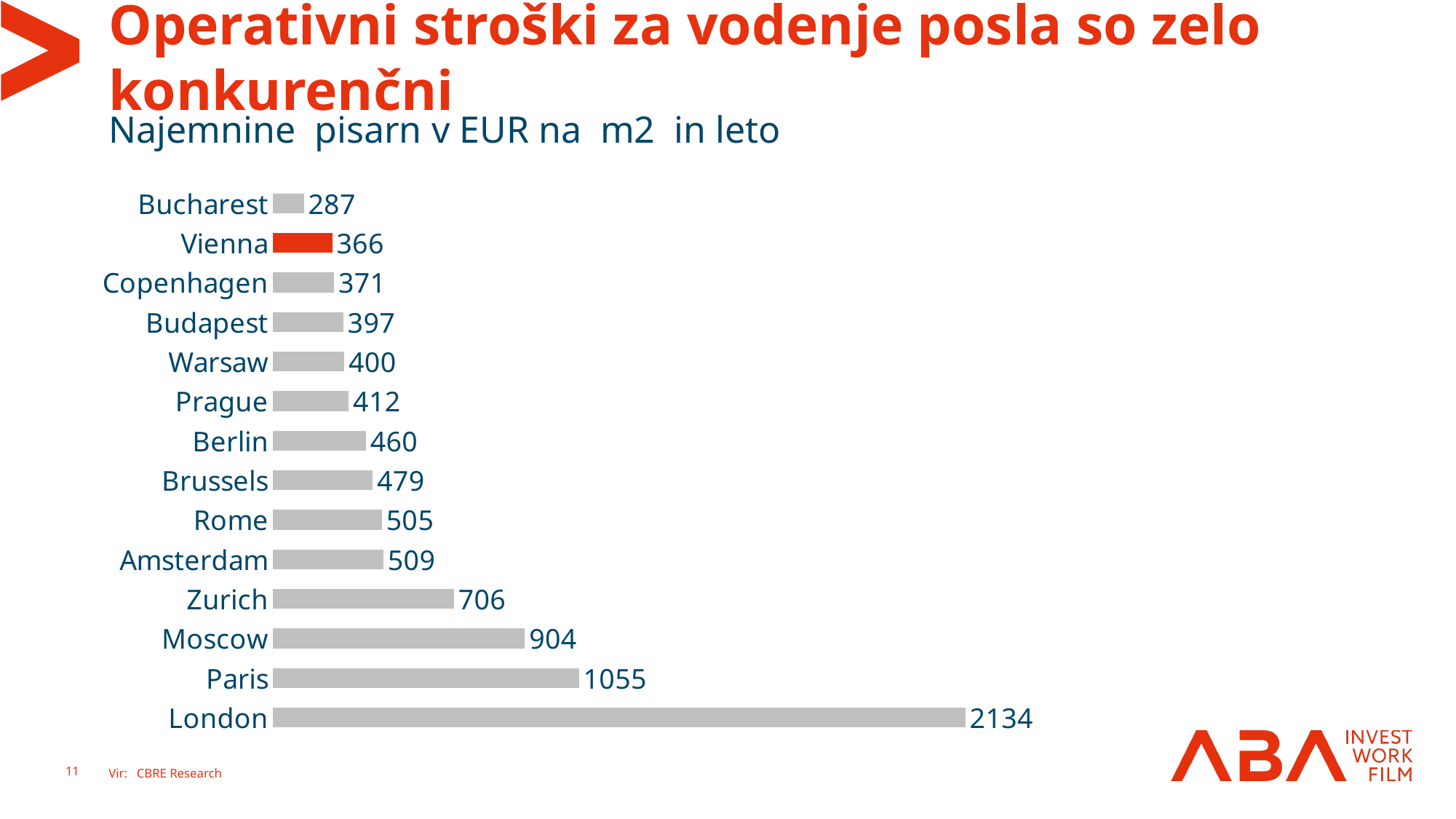
Which city has the highest office rent on the chart? London Which has a higher value, Zurich or Amsterdam? Zurich What type of chart is shown on the slide? Bar chart What is the difference between the values for Vienna and Bucharest? 79 What is the office rent value shown for Vienna? 366 Which has a higher value, Berlin or Brussels? Brussels What is the value shown for Prague? 412 Which city has the lowest office rent on the chart? Bucharest What is the value shown for Moscow? 904 How many cities are shown on the chart? 14 Which city's bar is highlighted in a different colour (red) from the others? Vienna What is the difference between the values for London and Paris? 1079